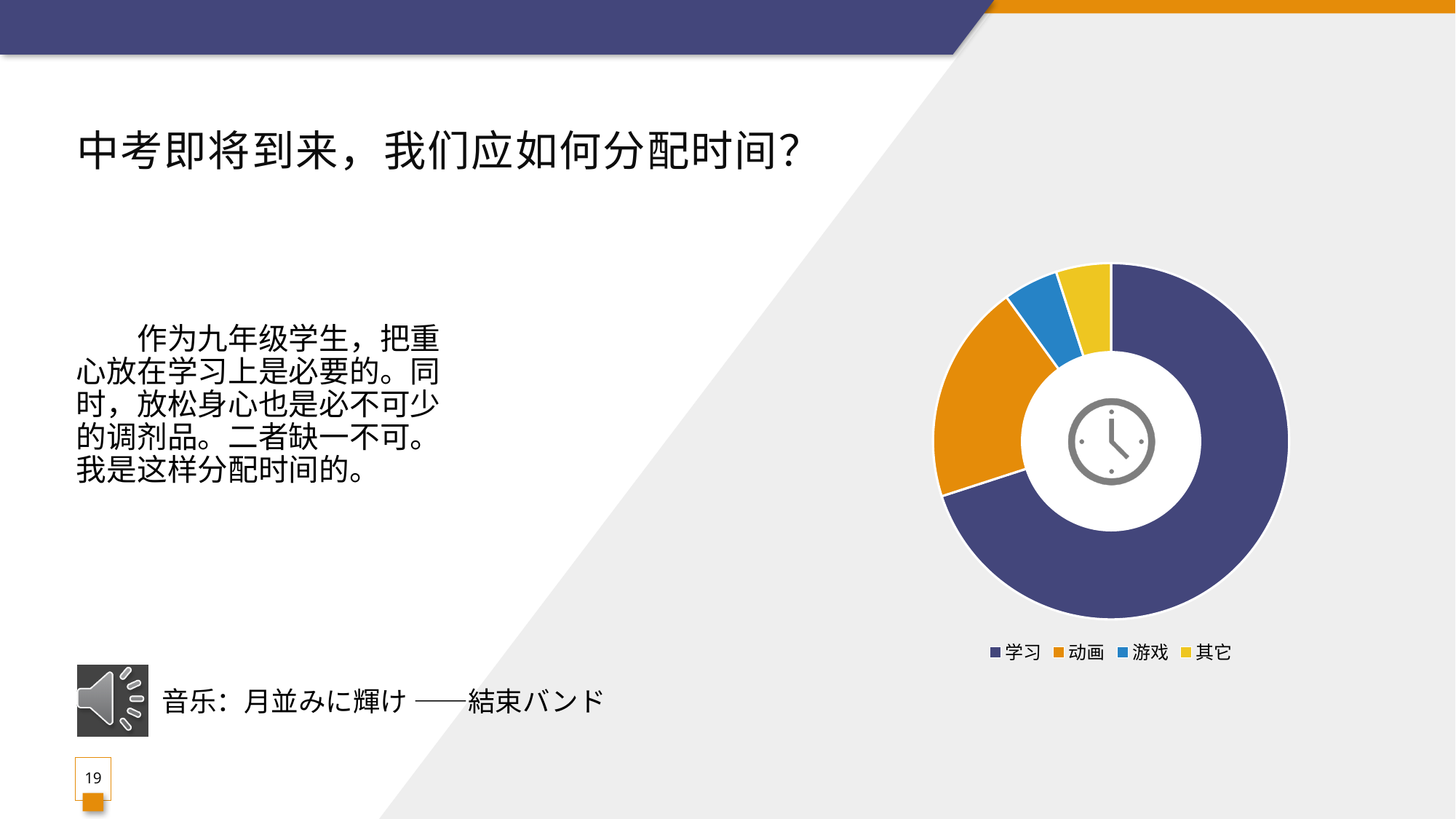
What kind of chart is shown on the slide? Doughnut (pie) chart How many entries does the chart's legend list? 4 Which is larger, the share for 学习 or the share for 动画? 学习 What are the legend entries of the chart, in order? 学习, 动画, 游戏, 其它 Which category takes up the largest share of the chart? 学习 Which category is the second largest in the chart? 动画 How many categories does the chart show? 4 What colour represents 学习 in the chart? Dark blue Which is larger, the share for 动画 or the share for 其它? 动画 Which is larger, the share for 动画 or the share for 游戏? 动画